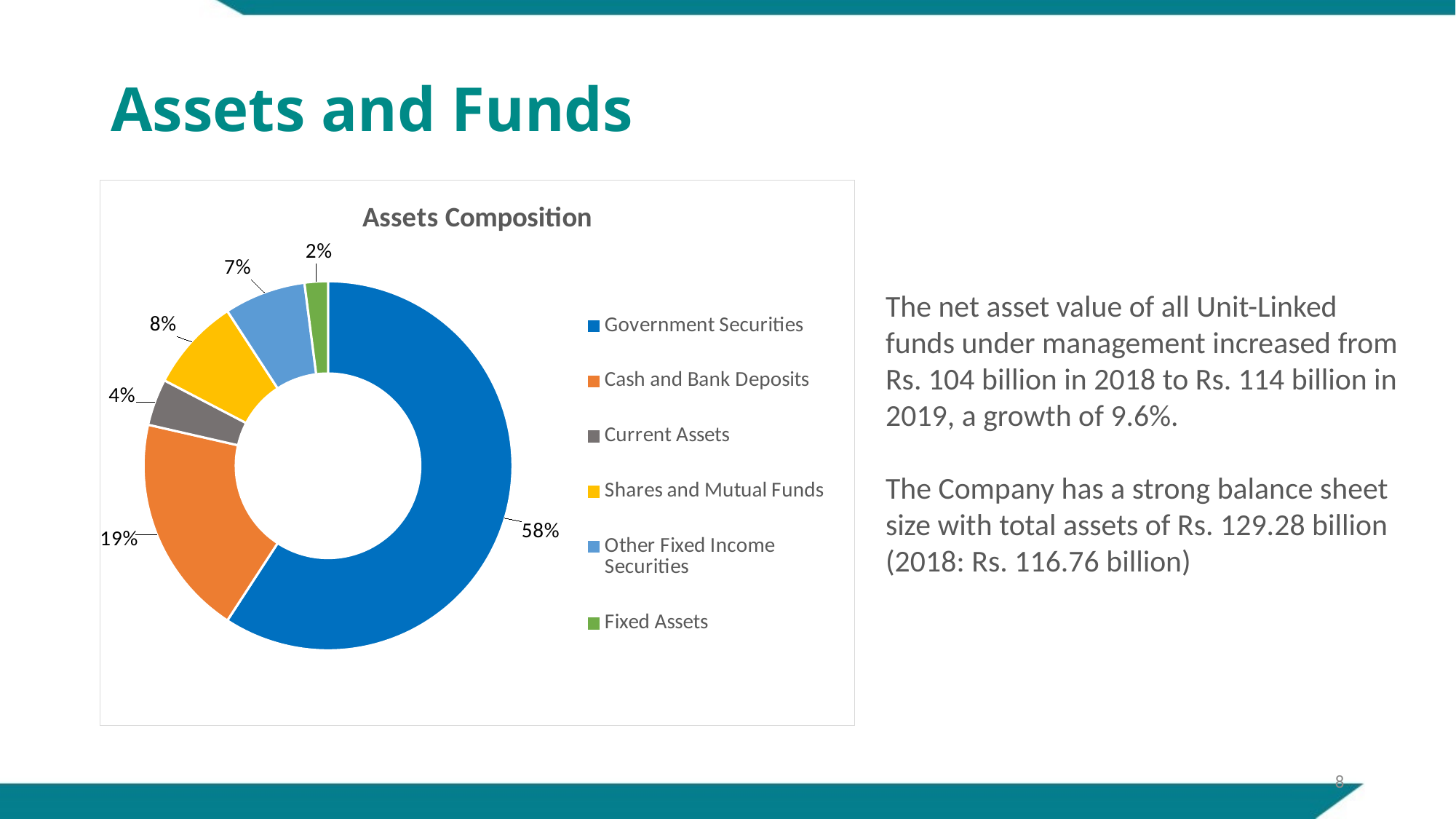
What share of assets is Government Securities in the Assets Composition chart? 58% What share of assets is Current Assets? 4% How many categories does the Assets Composition chart show? 6 What share of assets is Shares and Mutual Funds? 8% What share of assets is Cash and Bank Deposits? 19% What share of assets is Other Fixed Income Securities? 7% What share of assets is Fixed Assets? 2% What is the difference in percentage points between Government Securities and Cash and Bank Deposits? 39 Which has a larger share, Shares and Mutual Funds or Other Fixed Income Securities? Shares and Mutual Funds Which category has the largest share in the Assets Composition chart? Government Securities What type of chart is the Assets Composition chart? Doughnut (pie) chart Which category has the smallest share in the Assets Composition chart? Fixed Assets